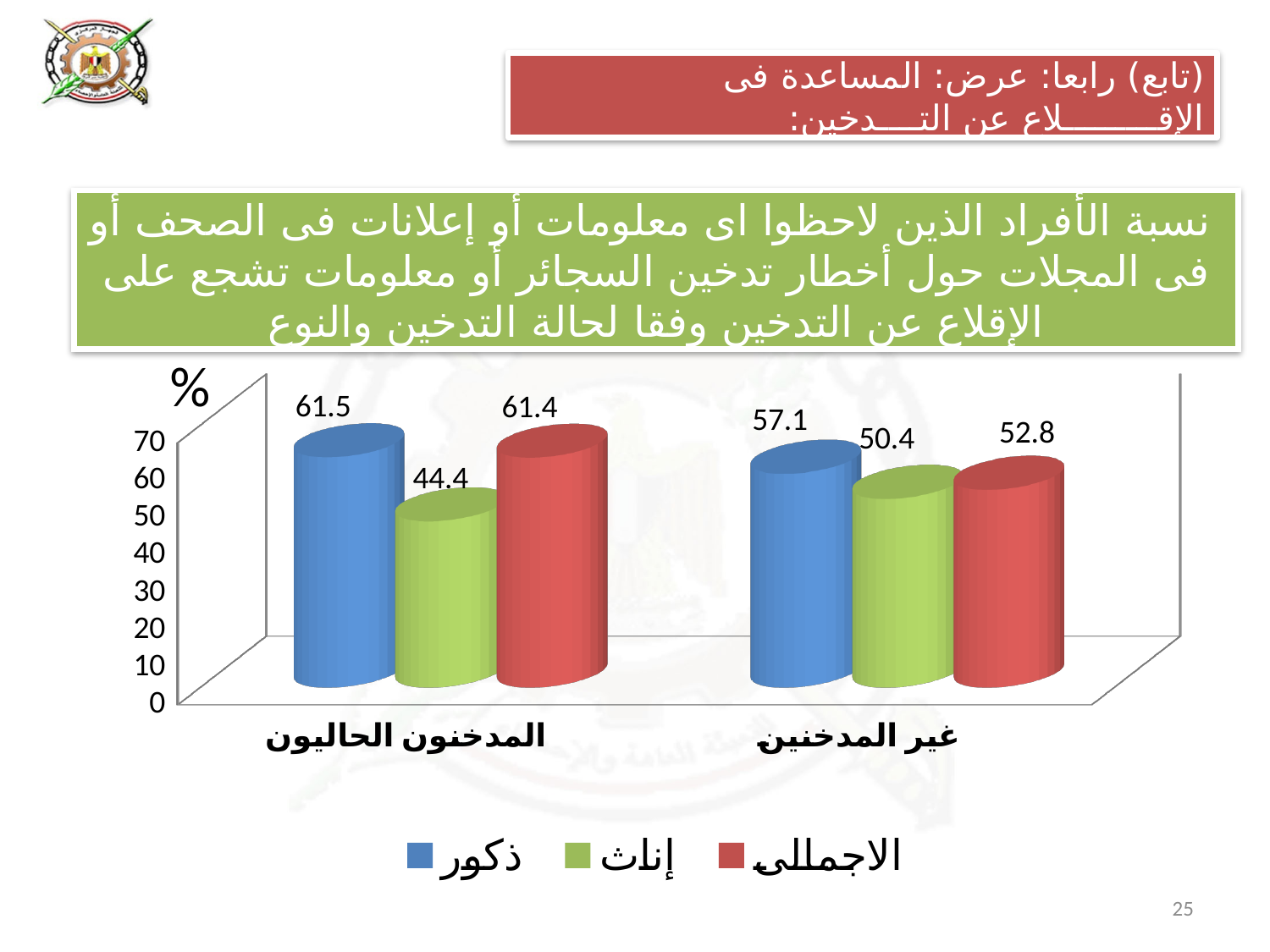
Which is larger: the إناث (females) value for المدخنون الحاليون or the إناث (females) value for غير المدخنين? غير المدخنين What is the difference between the ذكور (males) value and the إناث (females) value among المدخنون الحاليون (current smokers)? 17.1 What is the value for الاجمالى (total) among غير المدخنين (non-smokers)? 52.8 What is the value for إناث (females) among المدخنون الحاليون (current smokers)? 44.4 Which series has the lowest value among المدخنون الحاليون (current smokers)? إناث How many series does the legend list? 3 Which series has the highest value among غير المدخنين (non-smokers)? ذكور What is the value for إناث (females) among غير المدخنين (non-smokers)? 50.4 What kind of chart is shown on the slide? bar chart How many categories are shown on the x axis? 2 What is the value for ذكور (males) among المدخنون الحاليون (current smokers)? 61.5 Is the value for ذكور (males) among غير المدخنين (non-smokers) greater or less than 50? greater